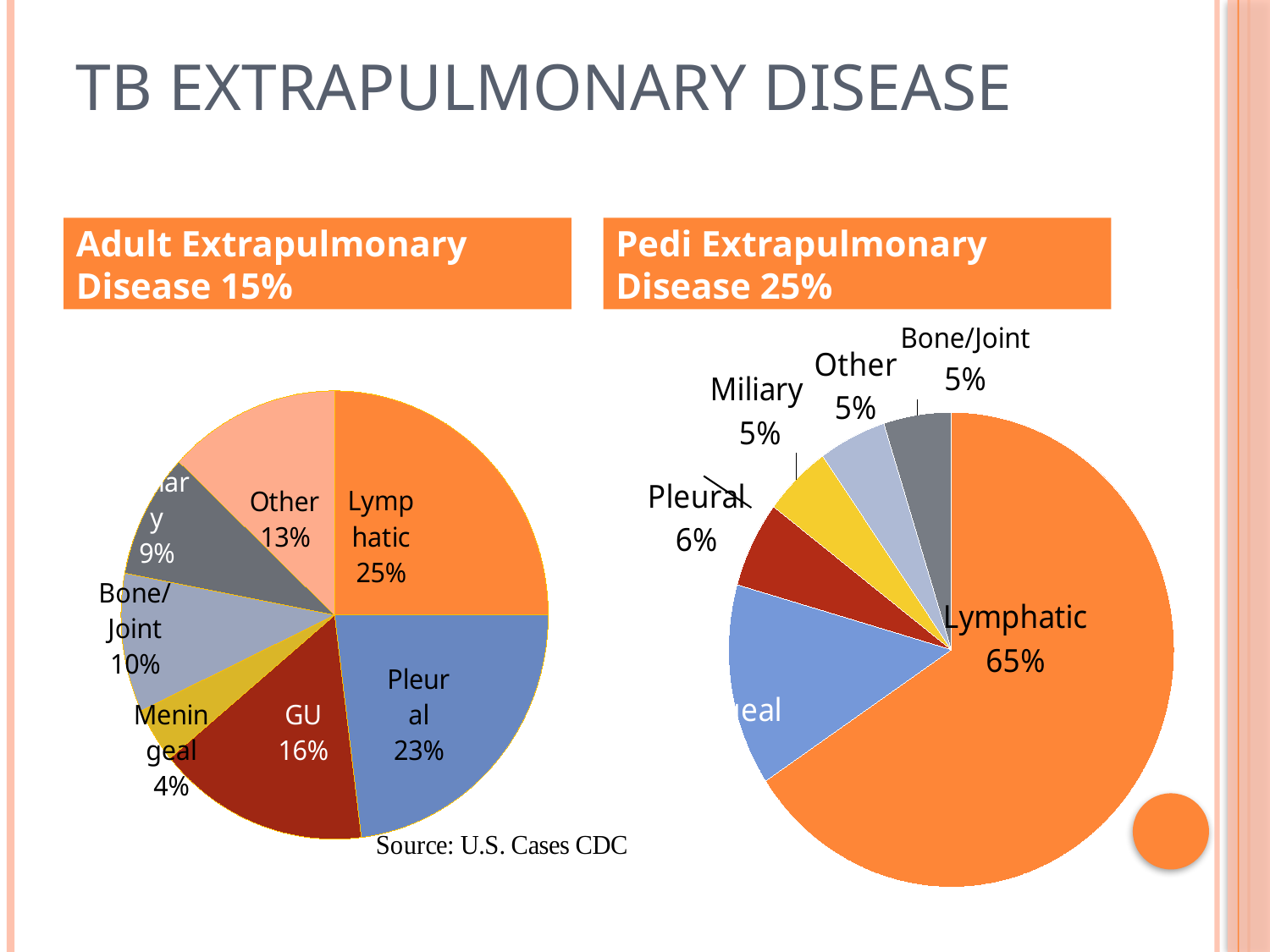
In the Adult Extrapulmonary Disease chart, what share is Bone/Joint? 10% In the Adult Extrapulmonary Disease chart, what share is GU? 16% In the Adult Extrapulmonary Disease chart, which category has the largest share? Lymphatic In the Adult Extrapulmonary Disease chart, which category has the smallest share? Meningeal In the Pedi Extrapulmonary Disease chart, what share is Lymphatic? 65% In the Pedi Extrapulmonary Disease chart, which is larger, Pleural or Miliary? Pleural In the Pedi Extrapulmonary Disease chart, what share is Pleural? 6% What is the source cited on the slide? U.S. Cases CDC In the Adult Extrapulmonary Disease chart, what share is Pleural? 23% In the Adult Extrapulmonary Disease chart, what is the difference between the Other share and the Bone/Joint share? 3% In the Adult Extrapulmonary Disease chart, what share is Lymphatic? 25% What kind of chart is the Pedi Extrapulmonary Disease chart? Pie chart